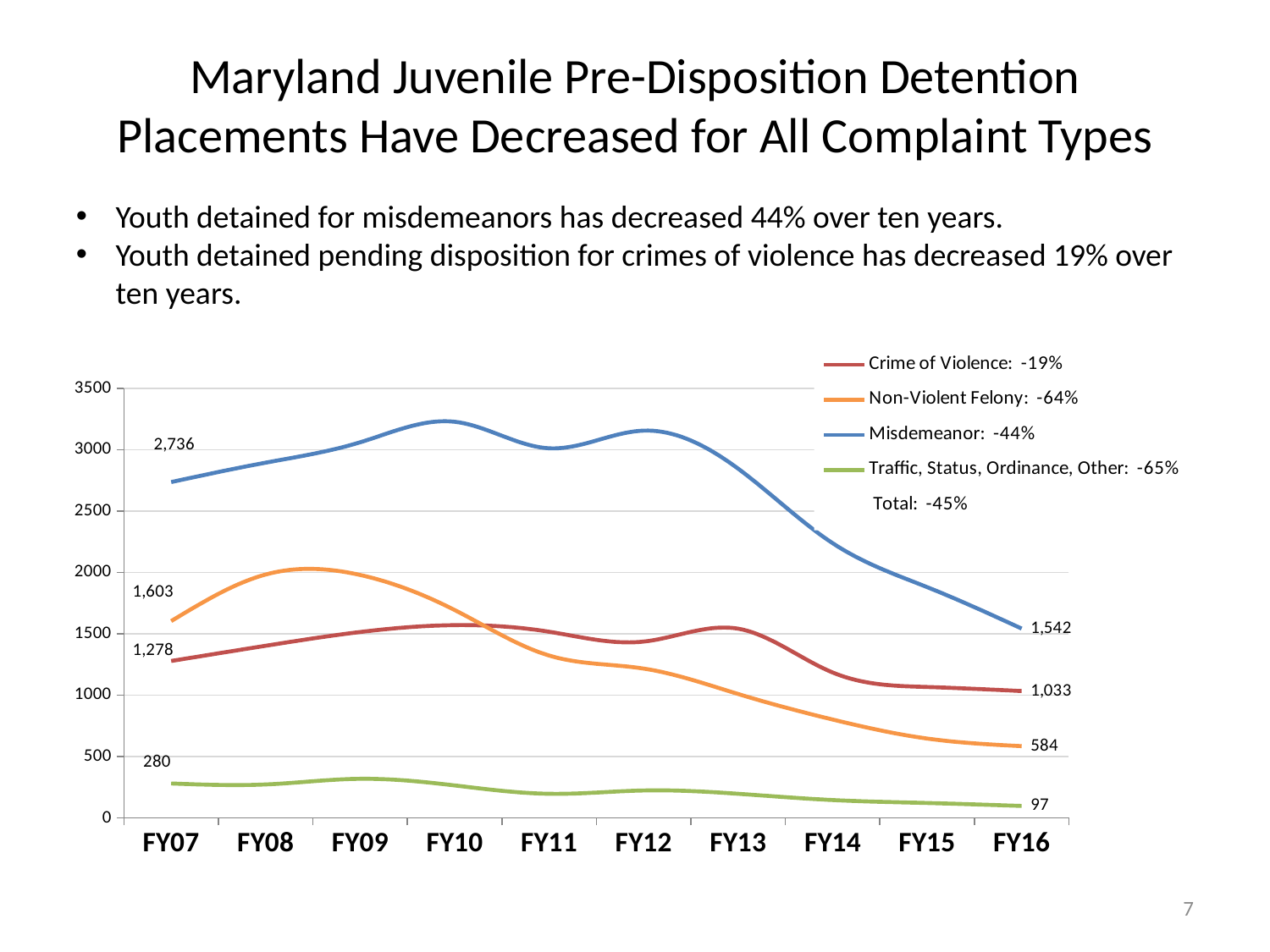
What is the difference between the Crime of Violence values in FY07 and FY16? 245 Which series has the highest value in FY07? Misdemeanor How many series does the legend list? 5 Which series has the lowest value in FY16? Traffic, Status, Ordinance, Other What is the Misdemeanor value in FY07? 2,736 Is the Misdemeanor value in FY10 greater or less than 3000? greater By how much did the Misdemeanor value fall from FY07 to FY16? 1,194 What kind of chart is shown on the slide? line chart What is the Non-Violent Felony value in FY16? 584 How many fiscal years are shown on the x axis? 10 In FY16, which is larger: Crime of Violence or Non-Violent Felony? Crime of Violence What is the value for Traffic, Status, Ordinance, Other in FY16? 97